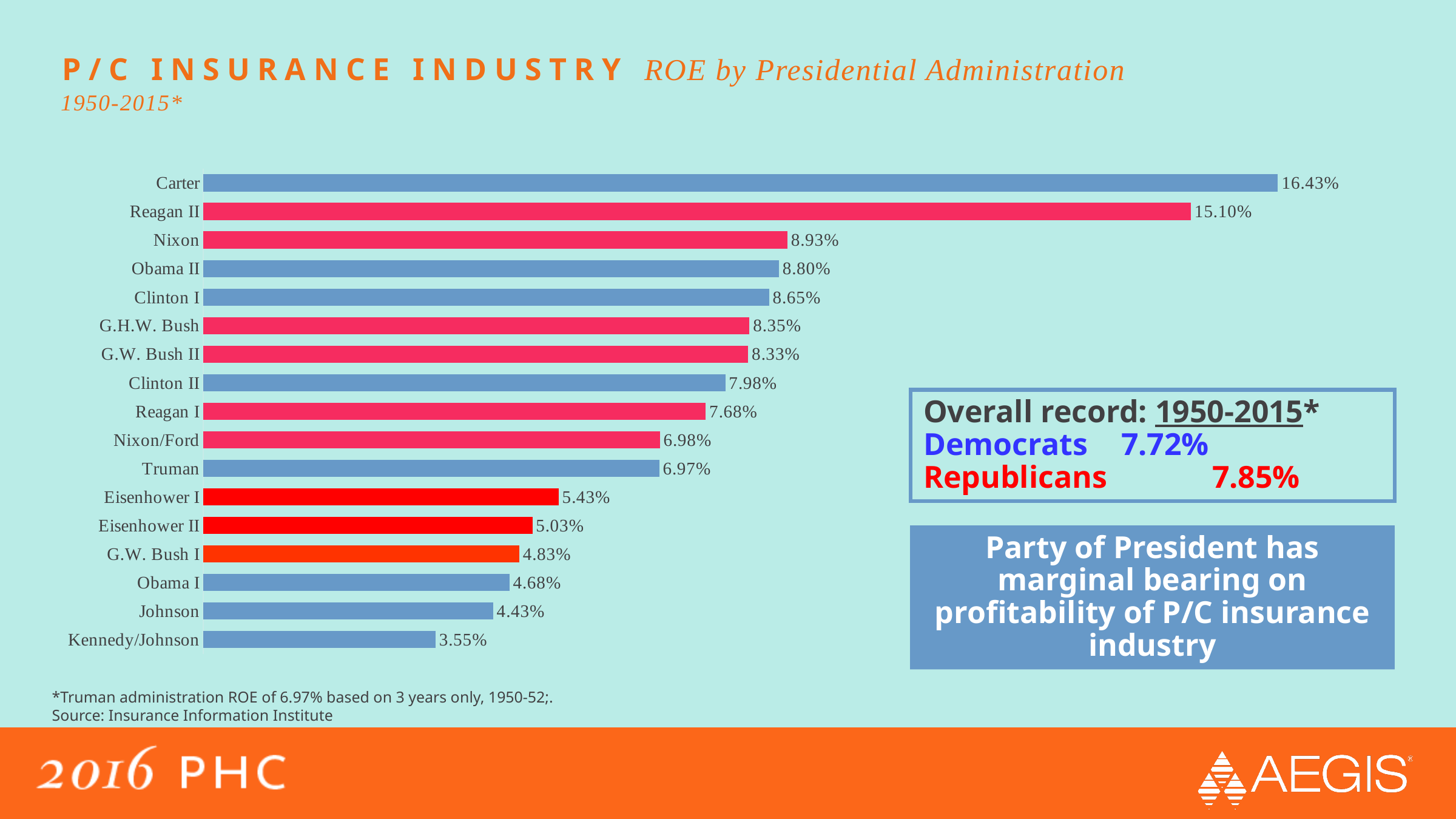
What is the ROE for the Eisenhower II administration? 5.03% What kind of chart is shown on the slide? Bar chart What is the ROE for the Carter administration? 16.43% Which administration has the lowest ROE? Kennedy/Johnson Which has a higher ROE, Clinton I or G.H.W. Bush? Clinton I Which has a higher ROE, Eisenhower I or Obama I? Eisenhower I Which administration has the highest ROE? Carter How many administrations are shown in the chart? 17 What is the difference in ROE between Nixon and Kennedy/Johnson? 5.38% What is the difference in ROE between Carter and Reagan II? 1.33% What is the ROE for the Nixon/Ford administration? 6.98% According to the text box, what is the overall ROE record for Republicans from 1950-2015? 7.85%